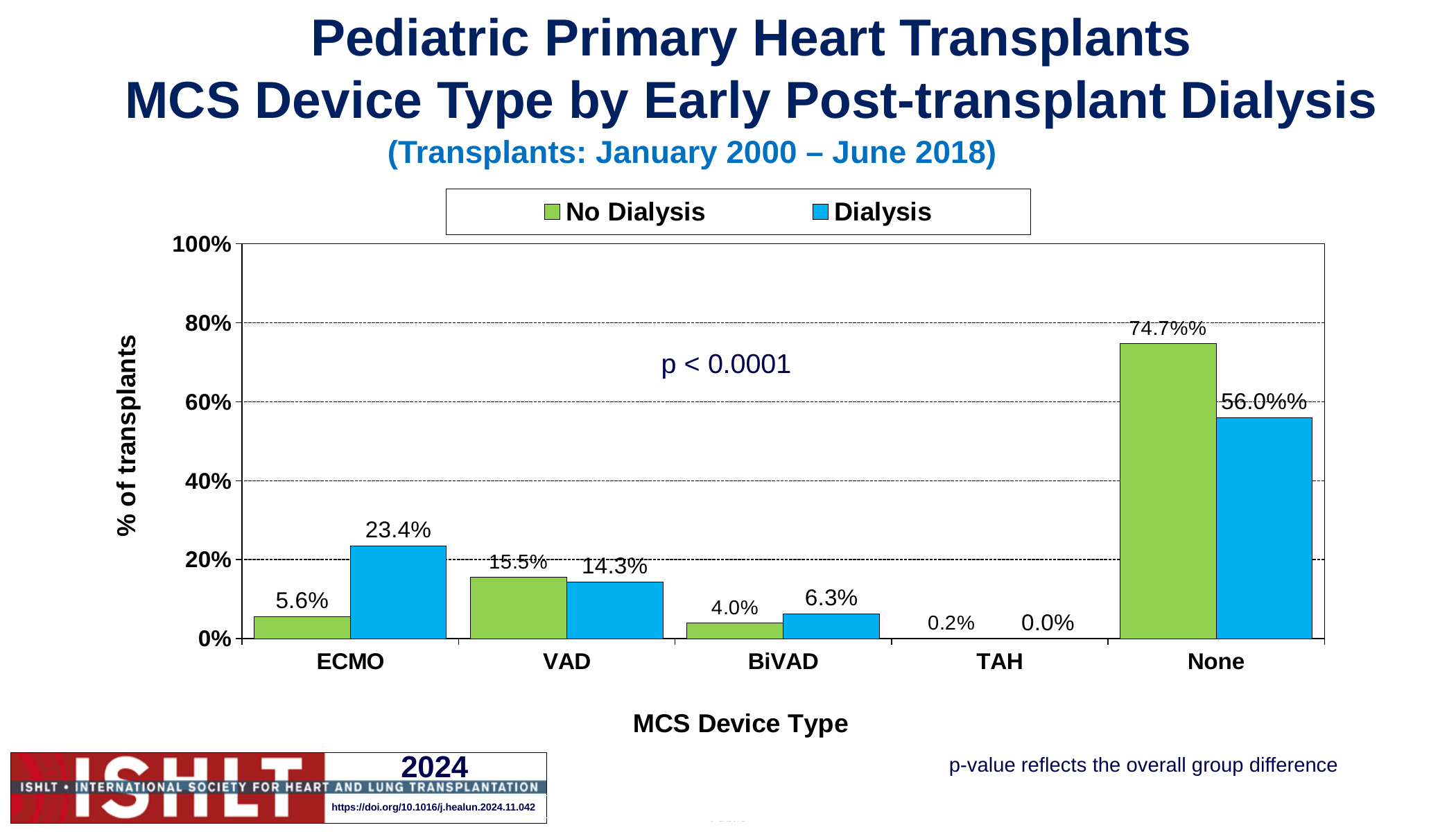
For the None category, which series has the larger value, No Dialysis or Dialysis? No Dialysis What is the Dialysis value for ECMO? 23.4% What is the Dialysis value for BiVAD? 6.3% What type of chart is shown on the slide? bar chart What is the No Dialysis value for VAD? 15.5% How many MCS device type categories are shown on the x axis? 5 Which MCS device type has the lowest Dialysis value? TAH Is the Dialysis value for None greater or less than 60%? less What is the difference between the Dialysis and No Dialysis values for ECMO? 17.8% What is the No Dialysis value for TAH? 0.2% Which MCS device type has the highest No Dialysis value? None How many series does the legend list? 2